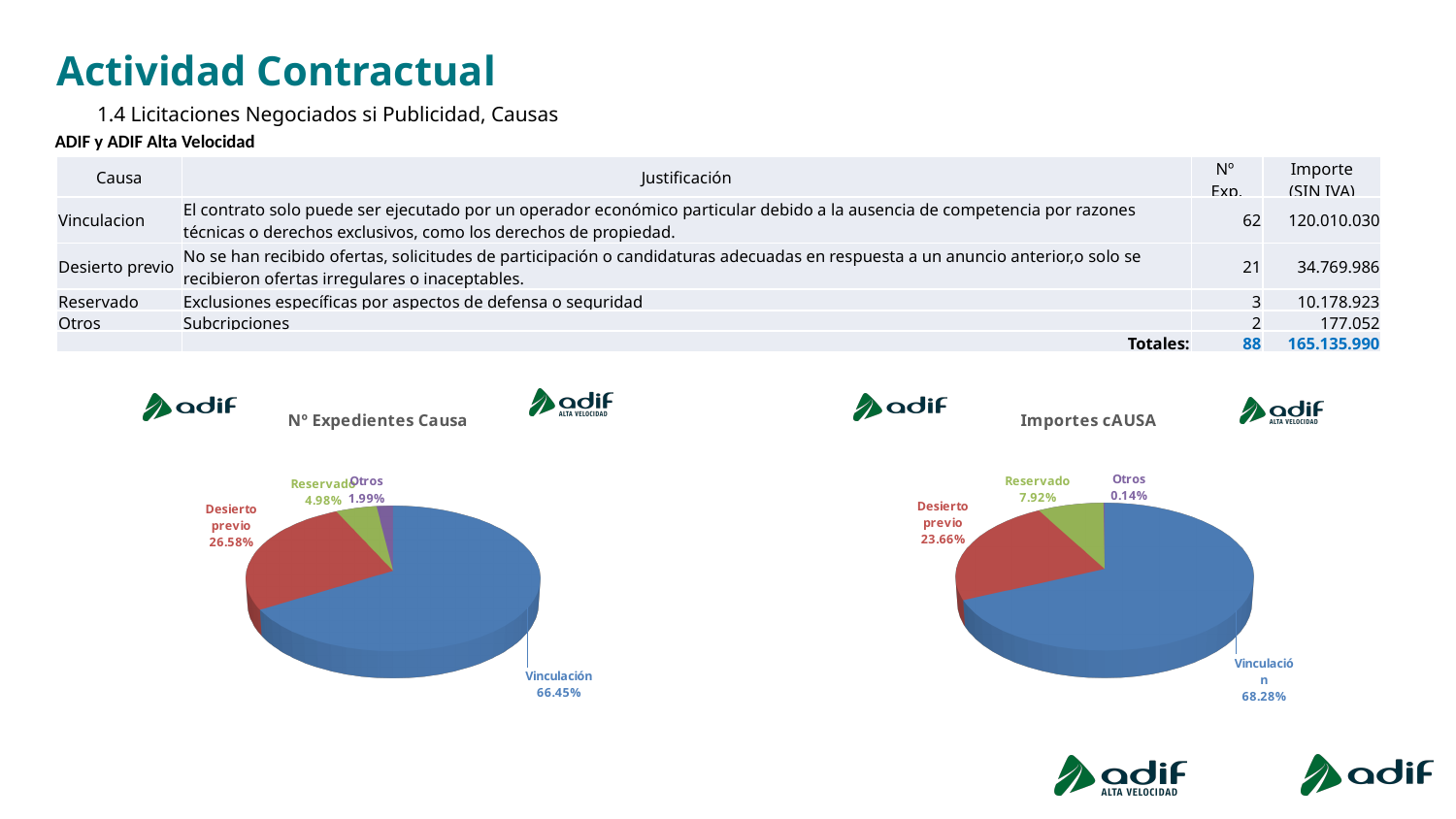
In the 'Nº Expedientes Causa' chart, which category has the largest slice? Vinculación In the 'Importes cAUSA' chart, what share does Reservado have? 7.92% In the 'Nº Expedientes Causa' chart, which is larger: Reservado or Otros? Reservado In the 'Nº Expedientes Causa' chart, what share does Vinculación have? 66.45% How many slices does the 'Importes cAUSA' chart have? 4 In the 'Importes cAUSA' chart, what is the difference between the Vinculación and Desierto previo shares? 44.62% In the 'Nº Expedientes Causa' chart, what share does Reservado have? 4.98% In the 'Importes cAUSA' chart, what share does Desierto previo have? 23.66% In the 'Importes cAUSA' chart, what share does Otros have? 0.14% In the 'Nº Expedientes Causa' chart, what share does Desierto previo have? 26.58% What type of chart is 'Nº Expedientes Causa'? Pie chart In the 'Importes cAUSA' chart, which category has the smallest slice? Otros